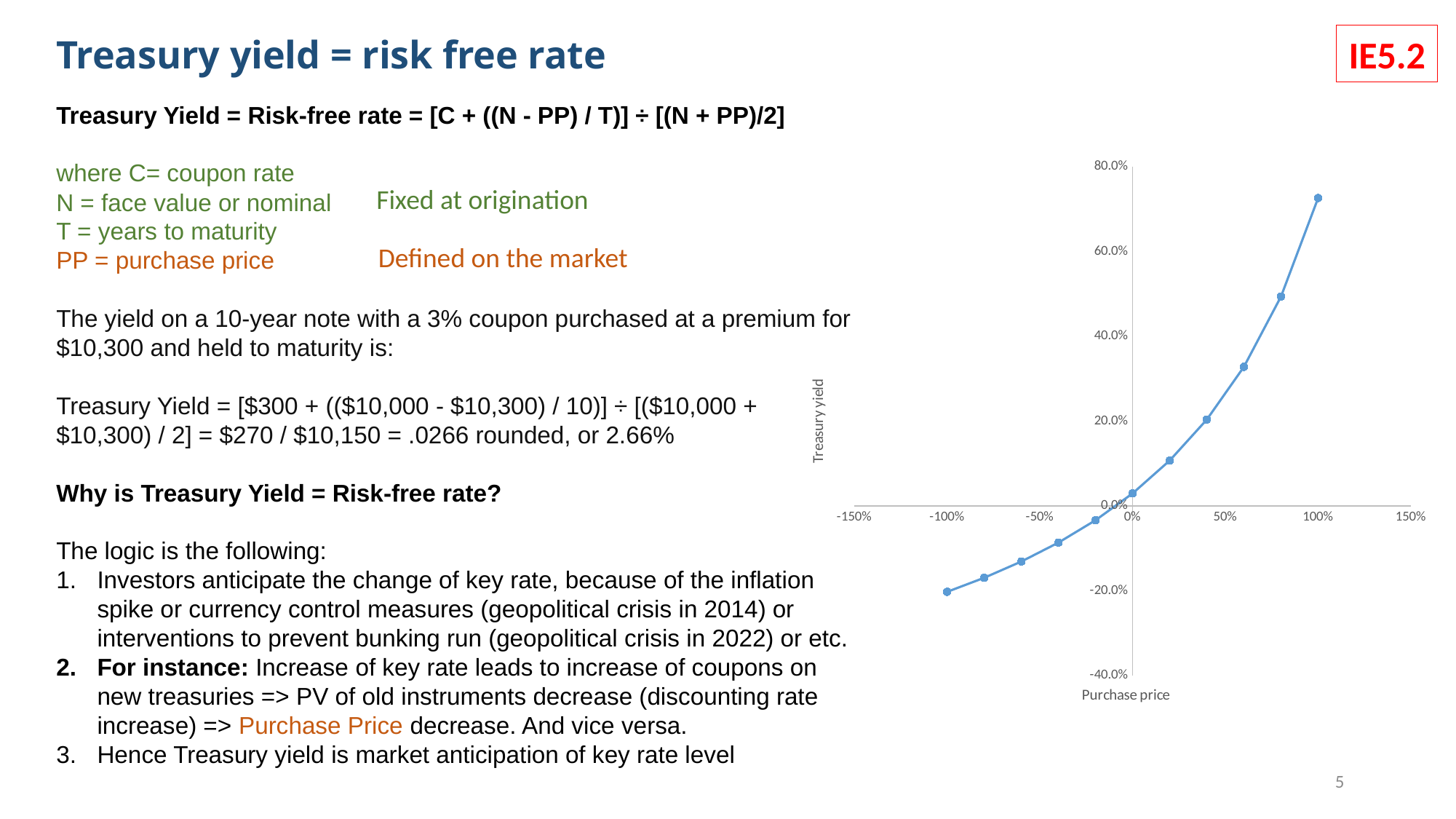
Is the Treasury yield at a purchase price of 80% greater or less than 40.0%? greater Does the Treasury yield rise or fall as the purchase price increases along the x axis? rise What kind of chart is shown on the slide? line chart At which purchase price value is the Treasury yield highest? 100% Is the Treasury yield at a purchase price of 100% greater or less than 60.0%? greater How many data points are plotted on the line? 11 At which purchase price value is the Treasury yield lowest? -100% Is the Treasury yield at a purchase price of 40% greater or less than 40.0%? less Which has the larger Treasury yield: a purchase price of 100% or a purchase price of 80%? 100% What is the label of the vertical axis of the chart? Treasury yield What is the label of the horizontal axis of the chart? Purchase price